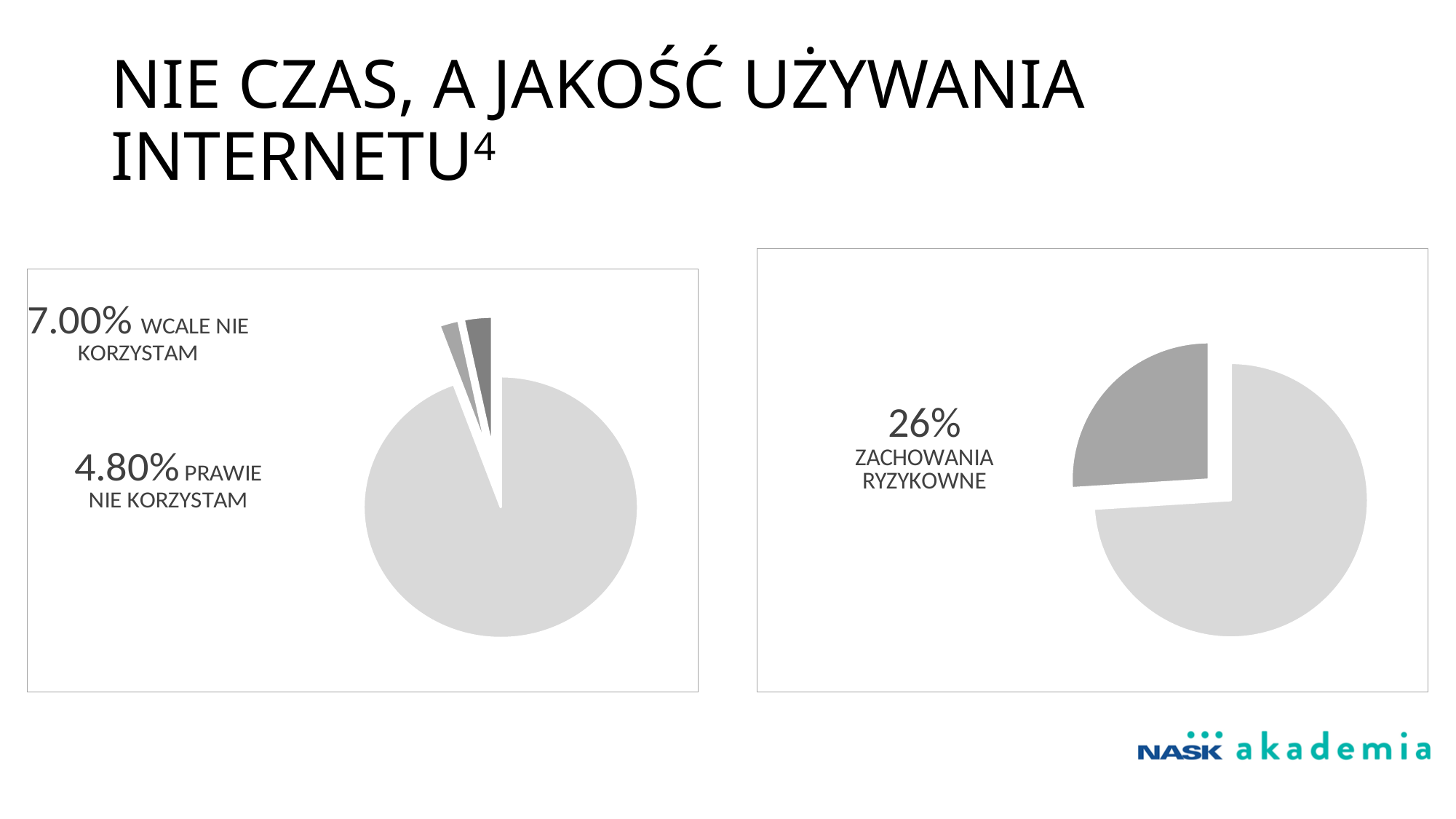
How many slices does the right pie chart have? 2 In the left pie chart, what percentage is shown for PRAWIE NIE KORZYSTAM? 4.80% What type of chart is shown on the left side of the slide? Pie chart In the right pie chart, what colour is the ZACHOWANIA RYZYKOWNE slice? Dark grey In the left pie chart, which of the two labeled slices is the smallest? PRAWIE NIE KORZYSTAM What type of chart is shown on the right side of the slide? Pie chart In the left pie chart, what percentage is shown for WCALE NIE KORZYSTAM? 7.00% How many slices does the left pie chart have? 3 In the left pie chart, what is the difference between the WCALE NIE KORZYSTAM and PRAWIE NIE KORZYSTAM percentages? 2.20% Which labeled value is larger: the 26% ZACHOWANIA RYZYKOWNE slice in the right chart or the 7.00% WCALE NIE KORZYSTAM slice in the left chart? ZACHOWANIA RYZYKOWNE In the right pie chart, what percentage is shown for ZACHOWANIA RYZYKOWNE? 26% In the left pie chart, which labeled slice is larger: WCALE NIE KORZYSTAM or PRAWIE NIE KORZYSTAM? WCALE NIE KORZYSTAM